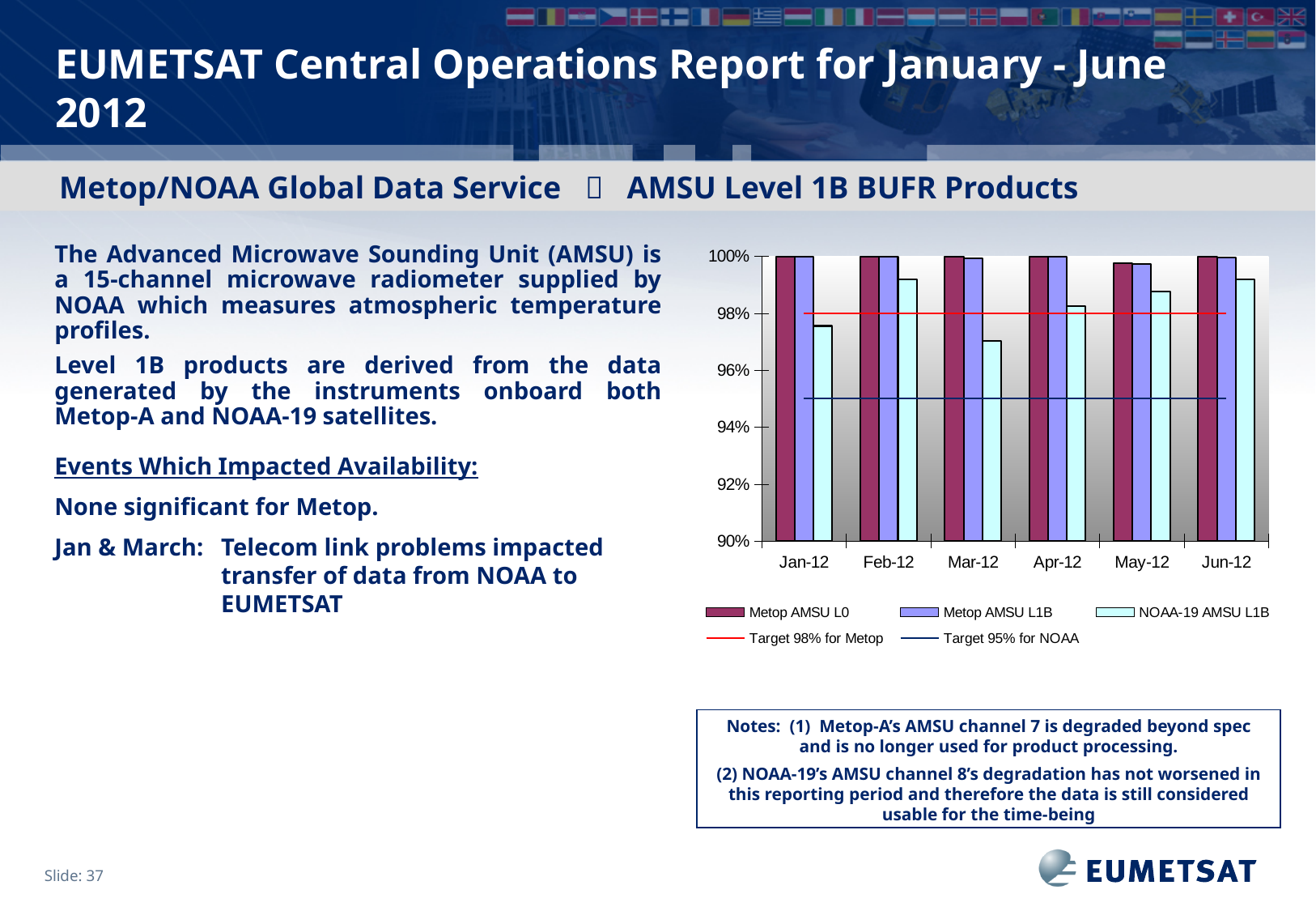
Which is larger in Mar-12: Metop AMSU L0 or NOAA-19 AMSU L1B? Metop AMSU L0 What target value does the red line in the chart represent? Target 98% for Metop Which is larger for NOAA-19 AMSU L1B: Feb-12 or Jan-12? Feb-12 How many entries does the chart legend list? 5 What kind of chart is shown on the slide? bar chart Which month has the lowest value for NOAA-19 AMSU L1B? Mar-12 Is the value for Metop AMSU L0 in May-12 greater or less than 98%? greater Is the value for NOAA-19 AMSU L1B in Jan-12 greater or less than 96%? greater How many months are shown on the x axis of the chart? 6 Is the value for NOAA-19 AMSU L1B in Feb-12 greater or less than 98%? greater What target value does the dark blue line in the chart represent? Target 95% for NOAA